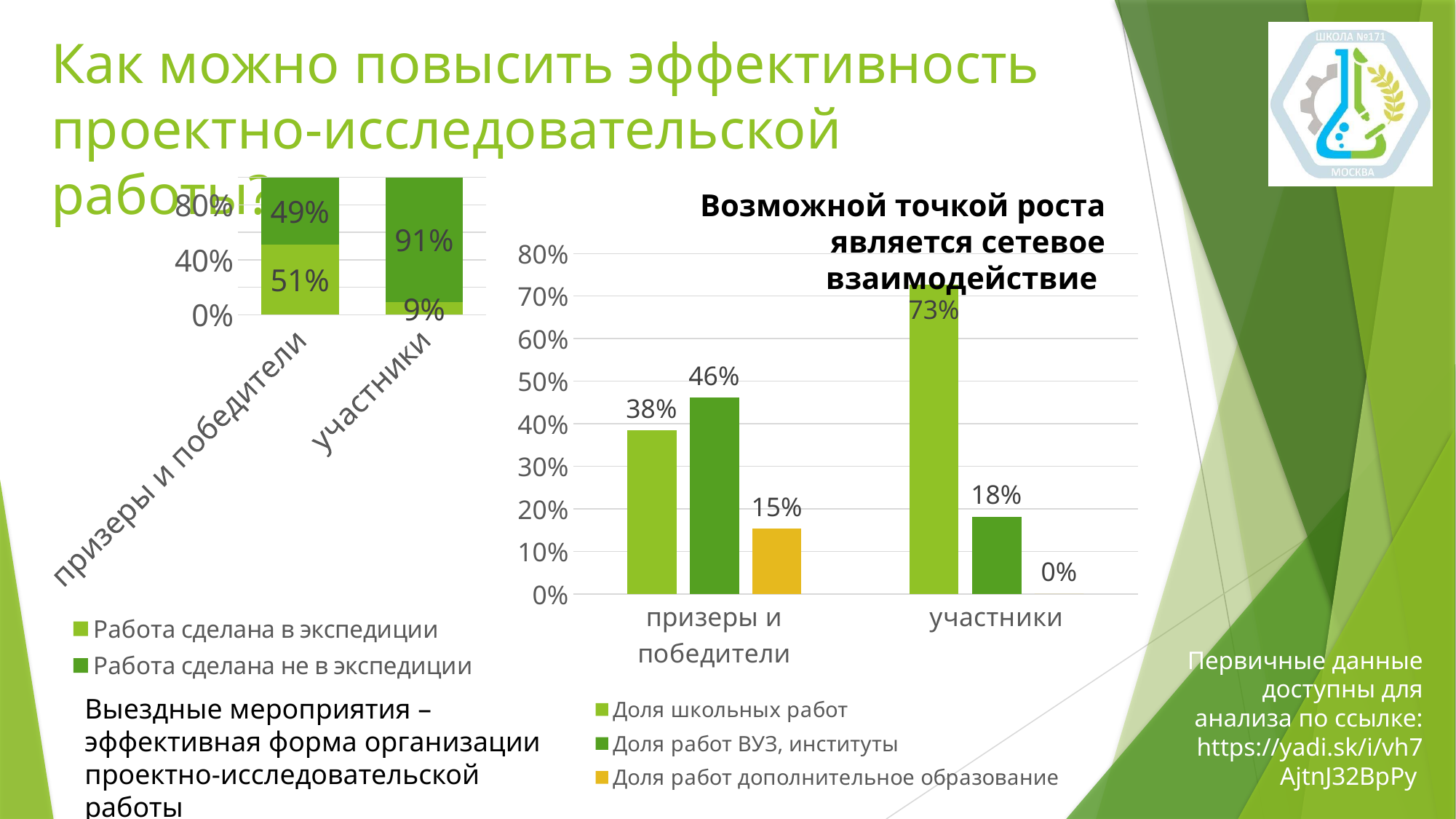
What kind of chart is the left-hand chart on the slide? Stacked bar chart In the left-hand stacked bar chart, what is the value of "Работа сделана не в экспедиции" for "участники"? 91% In the right-hand chart, what is the value of "Доля работ дополнительное образование" for "участники"? 0% In the right-hand chart, which series has the highest value for "призеры и победители"? Доля работ ВУЗ, институты In the left-hand stacked bar chart, what is the value of "Работа сделана в экспедиции" for "призеры и победители"? 51% What is the title of the right-hand chart? Возможной точкой роста является сетевое взаимодействие In the right-hand chart, which is larger for "участники": "Доля школьных работ" or "Доля работ ВУЗ, институты"? Доля школьных работ In the right-hand chart, what is the value of "Доля работ ВУЗ, институты" for "призеры и победители"? 46% In the left-hand stacked bar chart, what is the total of the stacked bar for "участники"? 100% How many series does the legend of the right-hand chart list? 3 In the right-hand chart, what is the difference between "Доля школьных работ" for "участники" and for "призеры и победители"? 35% In the right-hand chart titled "Возможной точкой роста является сетевое взаимодействие", what is the value of "Доля школьных работ" for "участники"? 73%